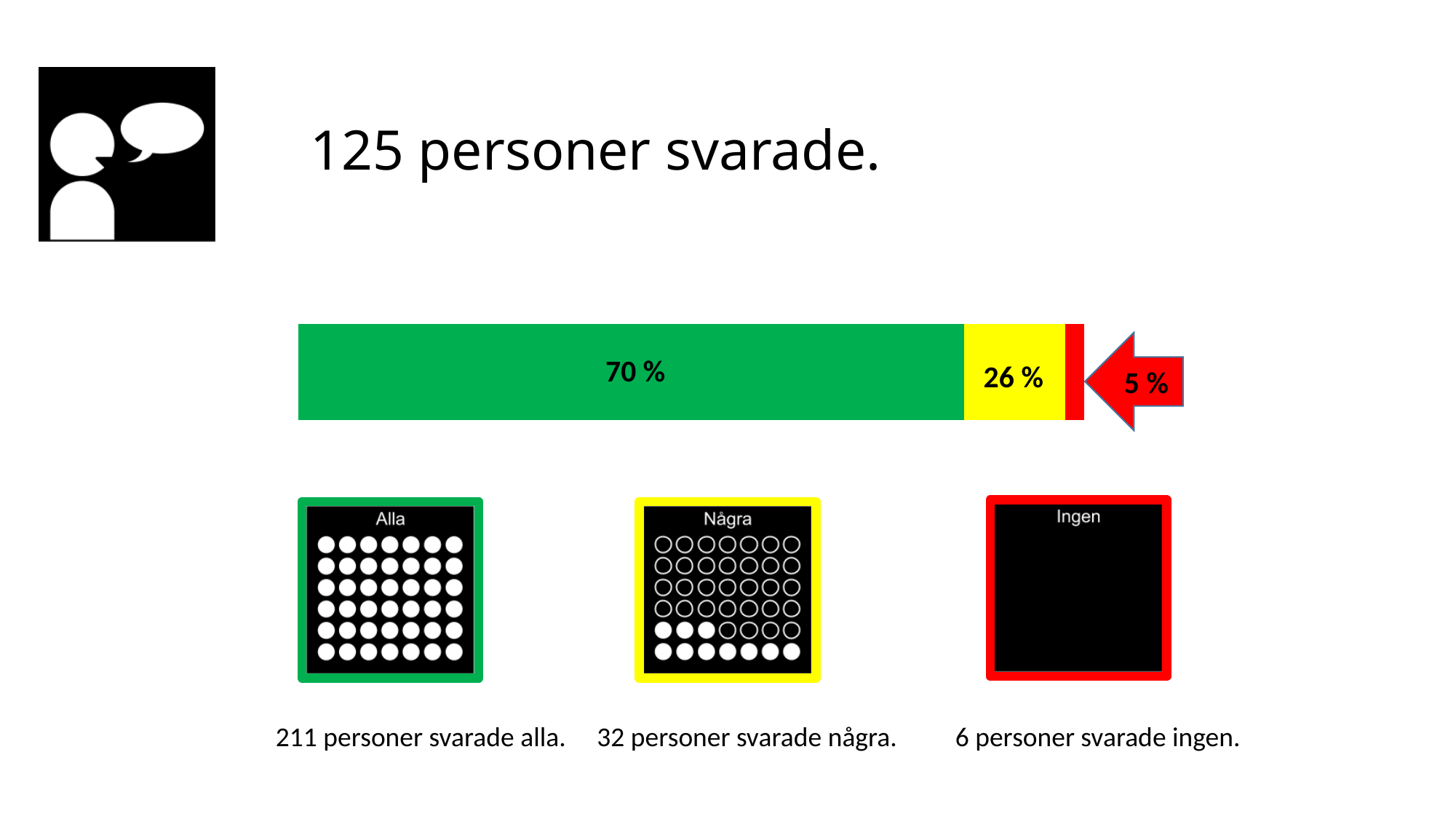
Which segment of the stacked bar has the smallest share? 5 % (red, Ingen) Which segment of the stacked bar has the largest share? 70 % (green, Alla) What percentage is shown on the green segment of the stacked bar? 70 % What kind of chart is shown on the slide? A stacked horizontal bar chart What is the title text at the top of the slide? 125 personer svarade. What colour is the segment labelled 26 %? Yellow Which is larger, the yellow segment or the red segment of the bar? The yellow segment (26 %) What percentage does the red arrow point to for the red segment of the bar? 5 % How many segments does the stacked bar have? 3 What is the difference in percentage points between the green segment and the yellow segment? 44 What is the difference in percentage points between the yellow segment and the red segment? 21 What percentage is shown on the yellow segment of the stacked bar? 26 %